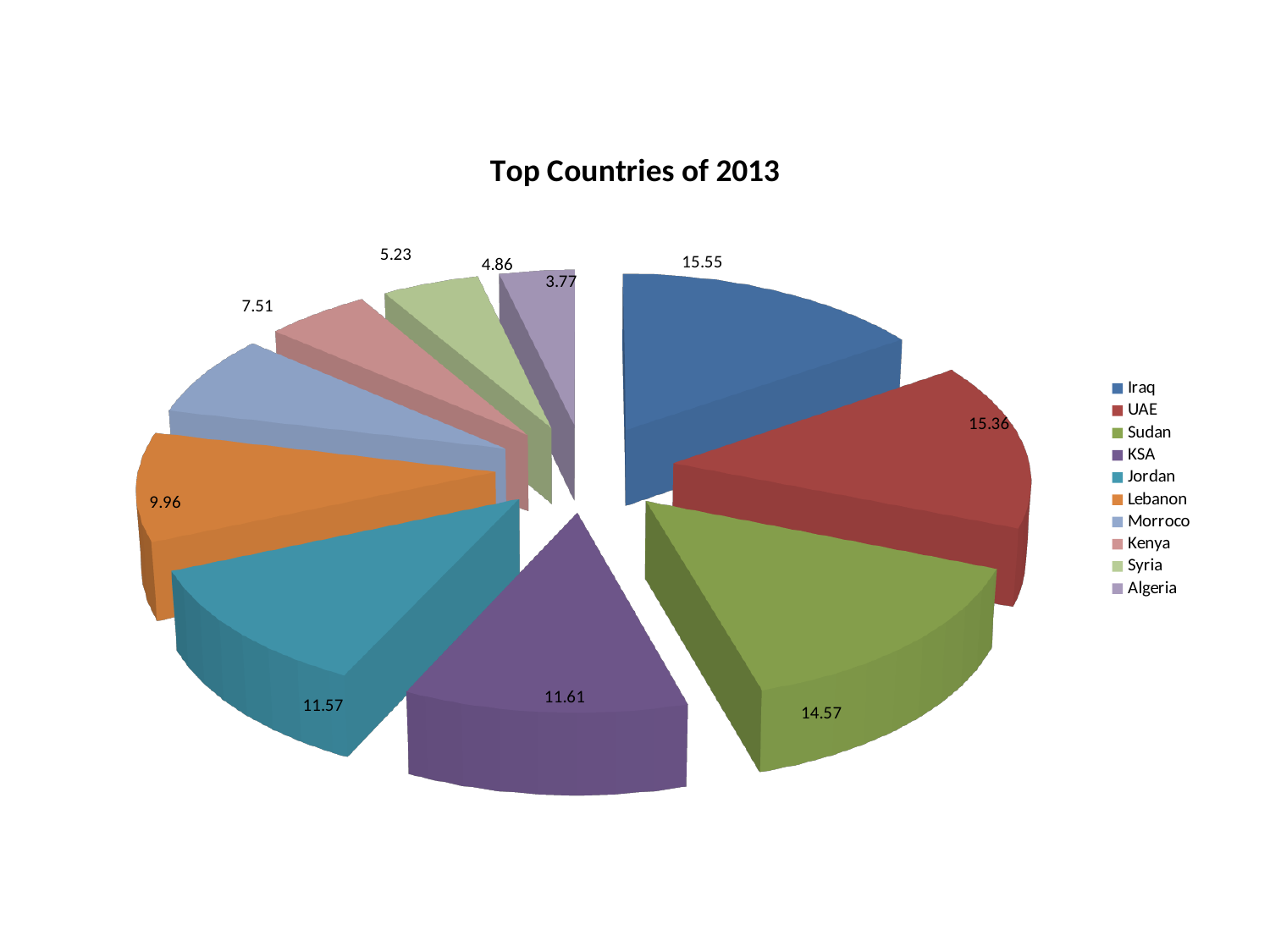
Which country has the smallest slice? Algeria How many countries are shown in the pie chart? 10 What is the value for Lebanon? 9.96 Which is larger, the value for Lebanon or the value for Morroco? Lebanon What kind of chart is shown on the slide? pie chart How many entries does the legend list? 10 What is the difference between the values for Iraq and Algeria? 11.78 What is the value for Syria? 4.86 What is the value for Sudan? 14.57 What is the value for Iraq? 15.55 Which country has the largest slice? Iraq What is the title of the chart? Top Countries of 2013